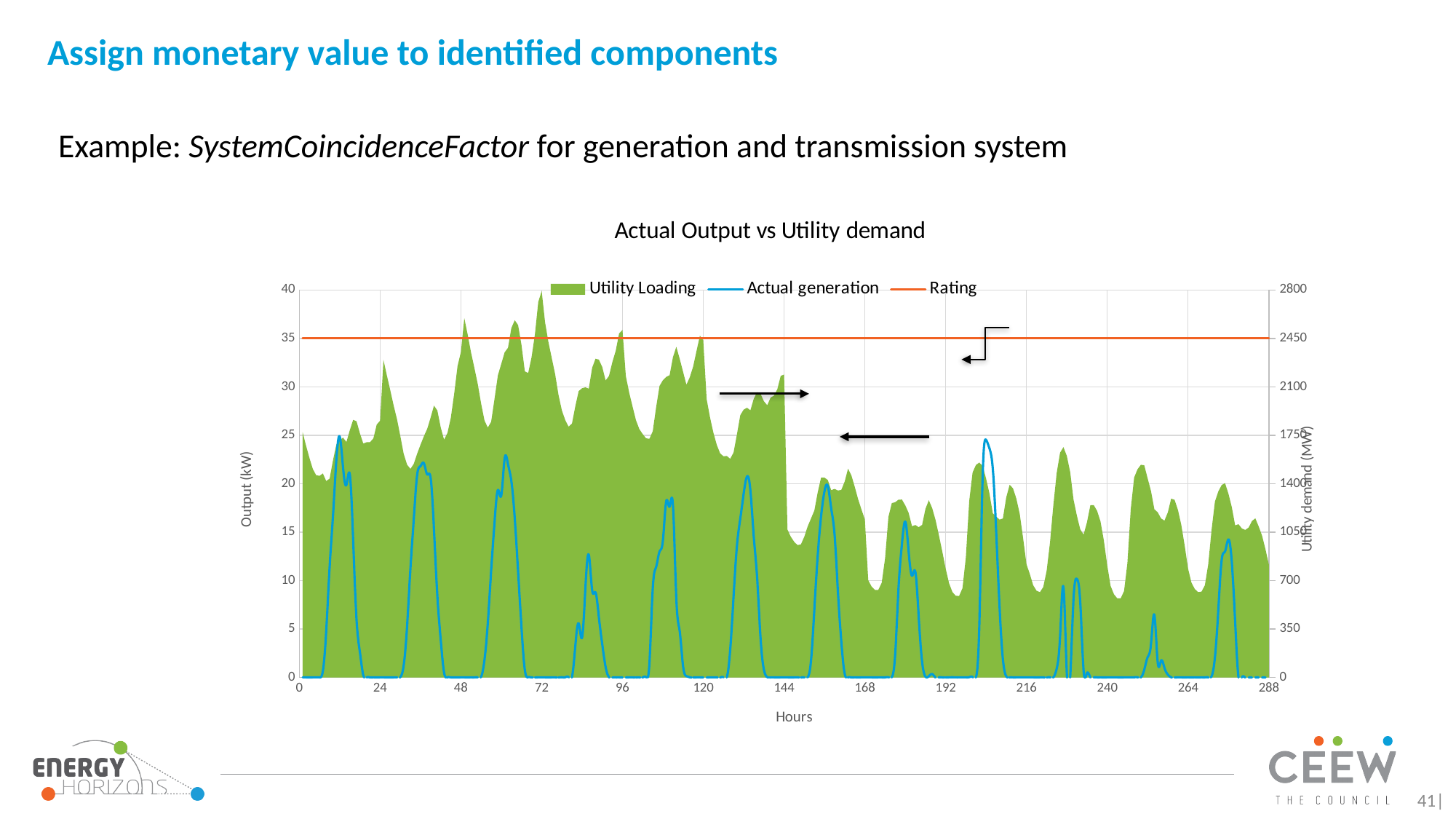
Is the Actual generation peak near hour 84 greater or less than 15 kW? less What is the last tick value on the Hours axis? 288 Does the Utility Loading series generally rise or fall from hour 0 to hour 288? fall Is the Utility Loading value near hour 72 greater or less than 35 on the left axis? greater Is the Actual generation peak near hour 12 greater or less than 20 kW? greater What is the highest value shown on the right-hand axis (Utility demand)? 2800 What is the label of the x axis of the chart? Hours How many series does the chart legend list? 3 What value does the Rating line sit at on the left axis? 35 Which is larger at hour 72: the Utility Loading value or the Rating value? Utility Loading What is the title of the chart? Actual Output vs Utility demand